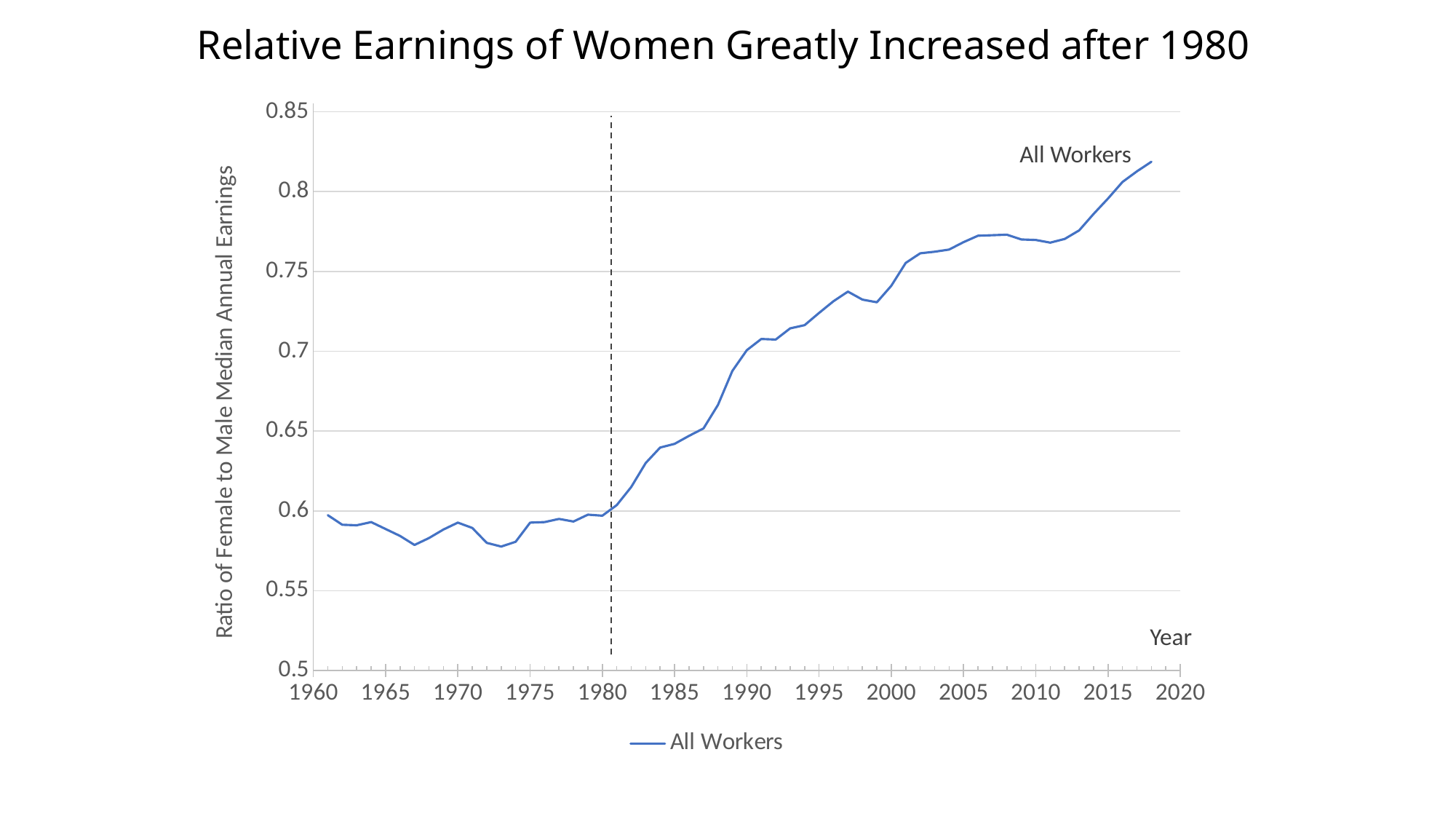
Is the value for All Workers in 1995 greater or less than 0.7? greater Is the value for All Workers in 1970 greater or less than 0.6? less What kind of chart is shown on the slide? line chart Is the value for All Workers in 2000 greater or less than 0.7? greater What is the label on the vertical axis? Ratio of Female to Male Median Annual Earnings How many series does the legend list? 1 Which year has a higher value for All Workers, 1975 or 2005? 2005 Does the All Workers line generally rise or fall from 1980 to 2018? rise What is the title of the chart? Relative Earnings of Women Greatly Increased after 1980